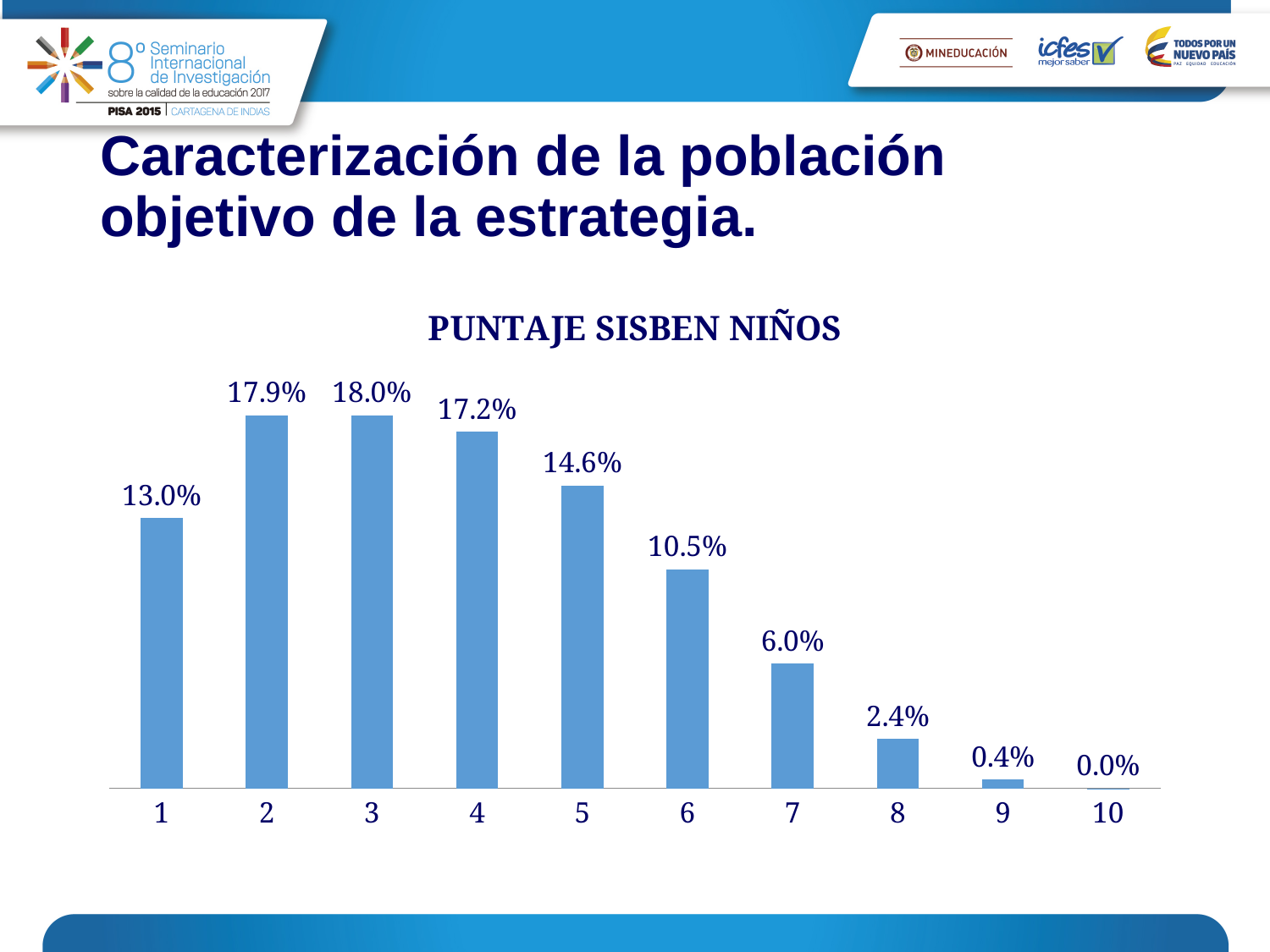
What is the title of the chart? PUNTAJE SISBEN NIÑOS How many categories are shown on the x axis? 10 Which category has the lowest value? 10 What kind of chart is this? bar chart What is the value for category 5? 14.6% What is the value for category 8? 2.4% Do the values rise or fall from category 3 to category 10? fall What is the value for category 1? 13.0% What is the difference between the values for category 3 and category 1? 5.0% What is the difference between the values for category 2 and category 7? 11.9% Which category has the highest value? 3 Which is larger, the value for category 4 or the value for category 6? 4